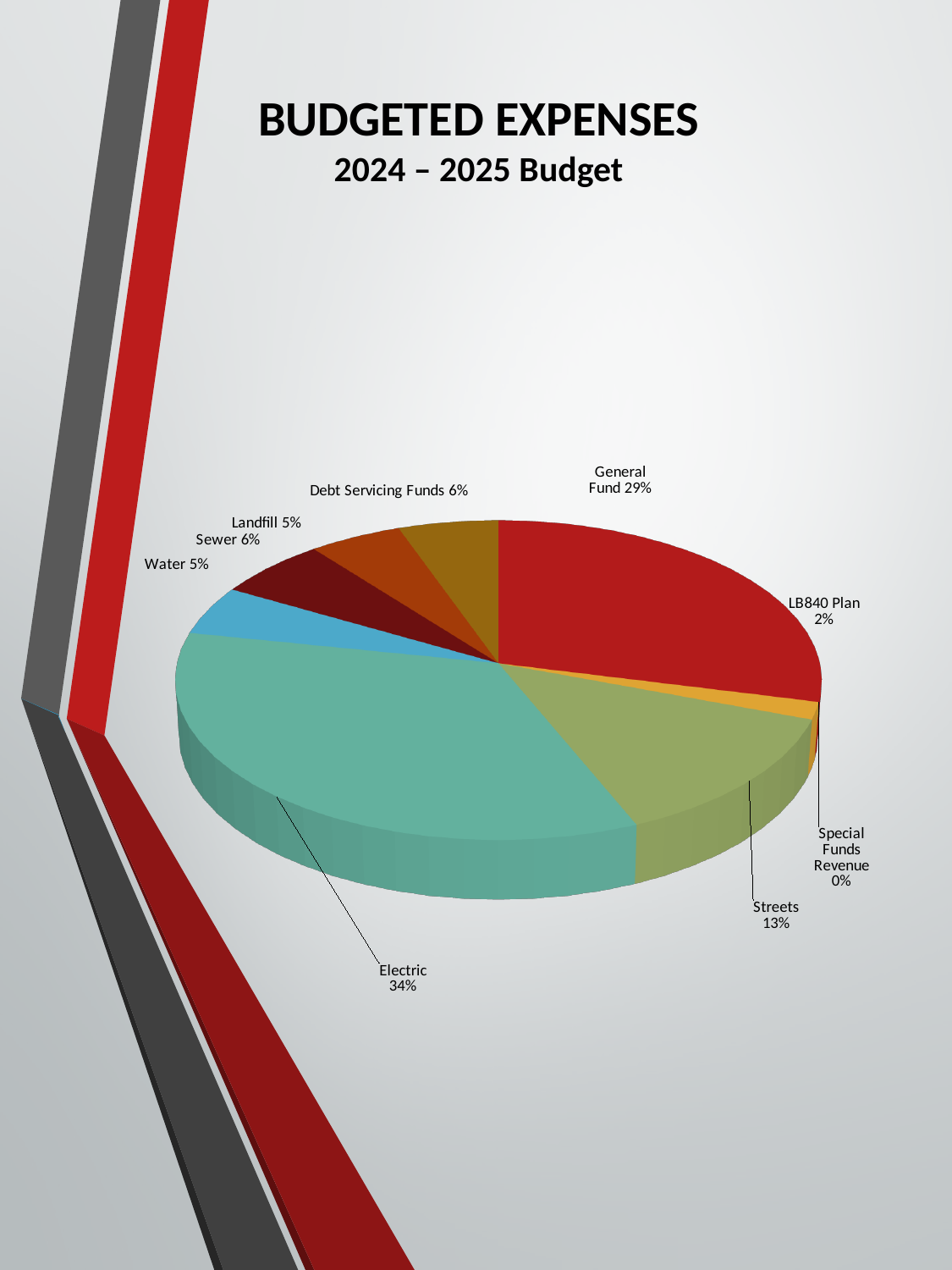
What is the difference in percentage points between Electric and the General Fund? 5 What kind of chart is shown on the slide? Pie chart Which is larger, the share for Sewer or the share for Water? Sewer What share of budgeted expenses does Electric account for? 34% What percentage is shown for Special Funds Revenue? 0% What share of budgeted expenses does the General Fund account for? 29% How many categories are shown in the pie chart? 9 Which category has the largest share of the pie? Electric What percentage is shown for Streets? 13% Which category has the smallest share of the pie? Special Funds Revenue What percentage is shown for the LB840 Plan? 2% What is the title of the chart on the slide? BUDGETED EXPENSES 2024 – 2025 Budget